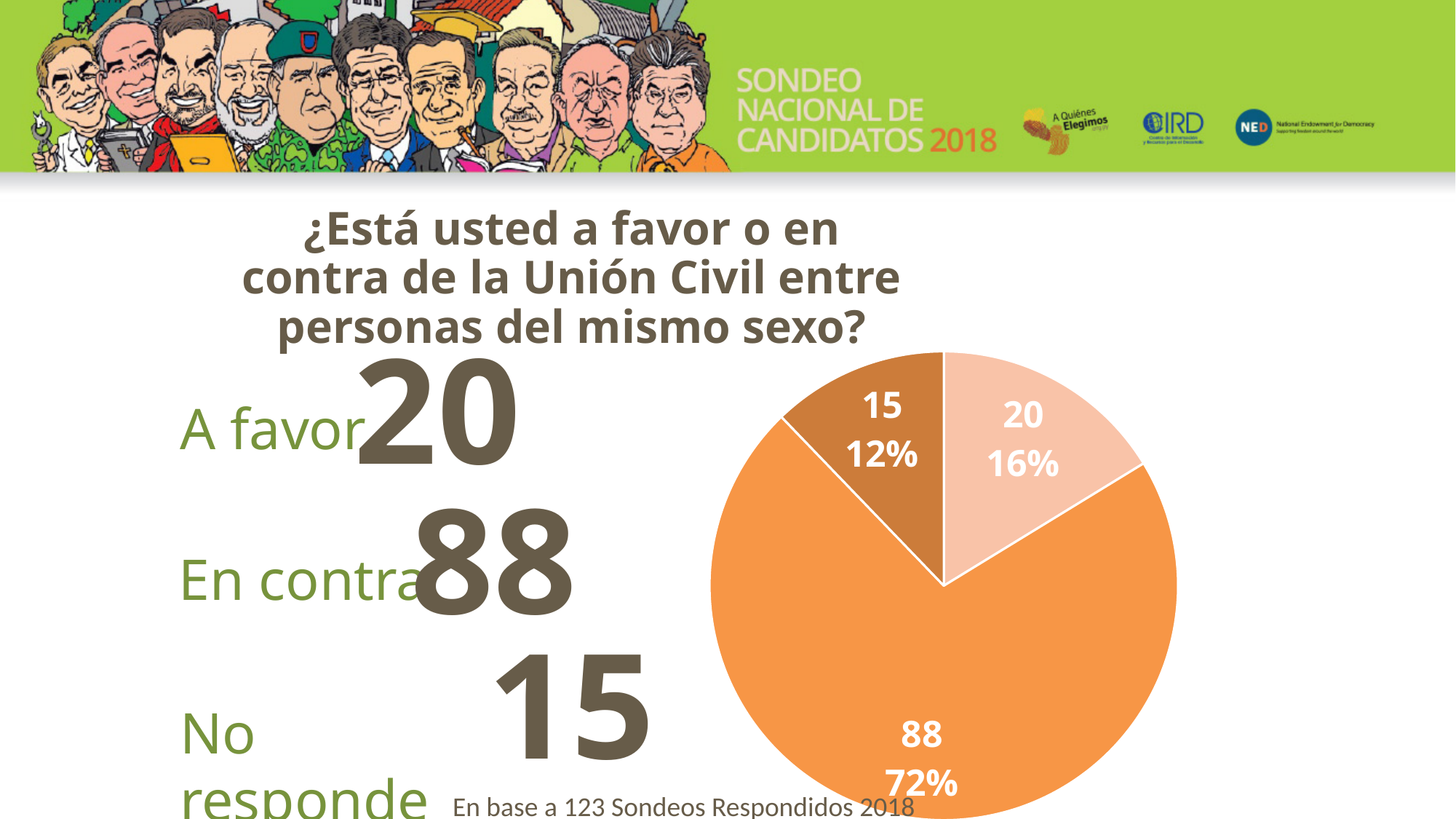
What kind of chart is shown on the slide? pie chart Which is larger, the "A favor" slice or the "No responde" slice? A favor What percentage share of the pie does "No responde" represent? 12% What percentage share of the pie does "A favor" represent? 16% Which response has the smallest slice of the pie? No responde How many respondents answered "En contra"? 88 Which response has the largest slice of the pie? En contra What is the difference between the number of "En contra" and "A favor" responses? 68 What percentage share of the pie does "En contra" represent? 72% How many slices does the pie chart have? 3 How many respondents answered "No responde"? 15 How many respondents answered "A favor"? 20